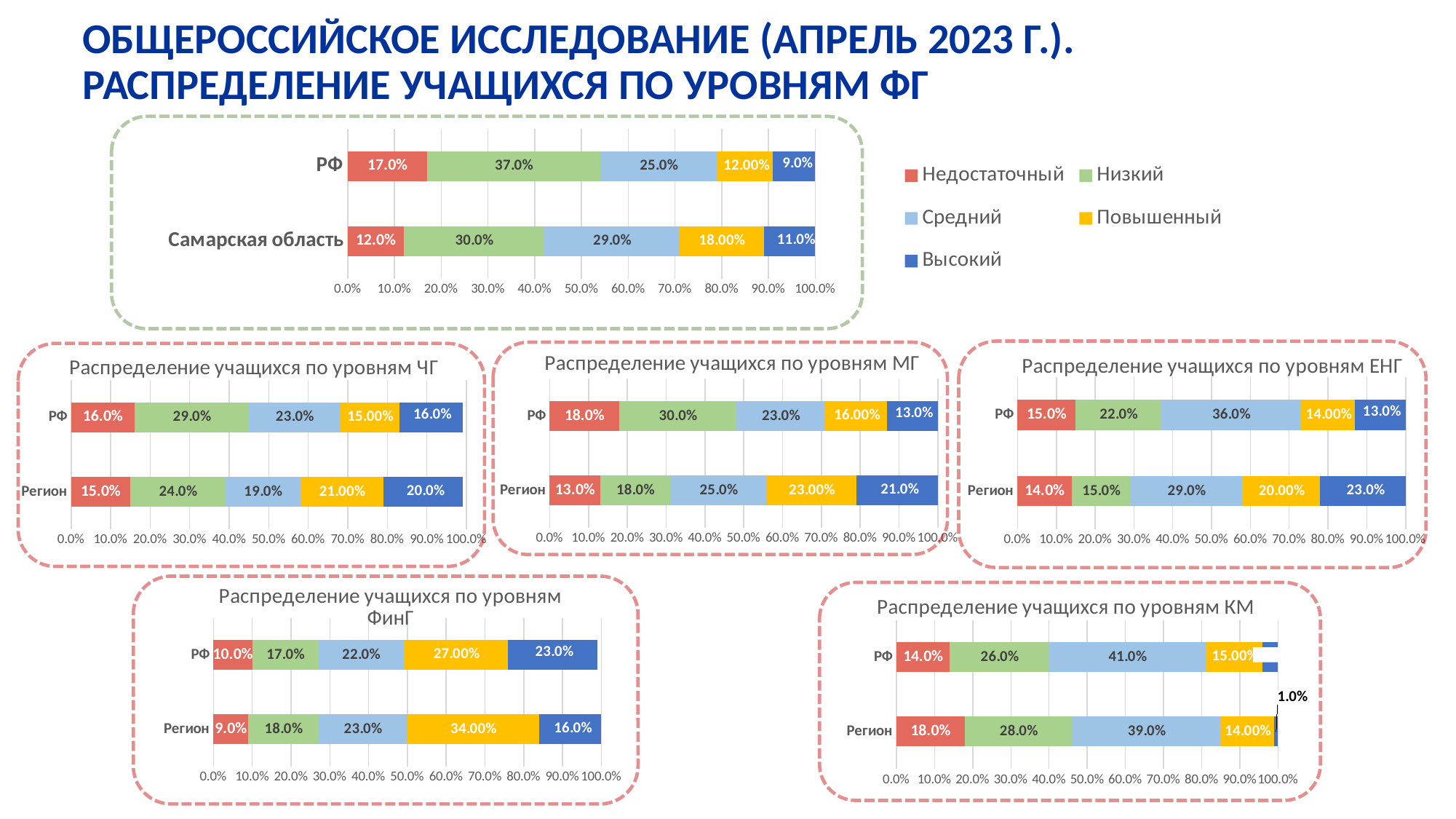
In the chart 'Распределение учащихся по уровням ФинГ', how much larger is the Повышенный share for Регион than for РФ? 7.00% In the chart 'Распределение учащихся по уровням МГ', which has the larger Недостаточный share, РФ or Регион? РФ In the chart 'Распределение учащихся по уровням ФинГ', what is the Повышенный value for Регион? 34.00% In the chart 'Распределение учащихся по уровням ЧГ', what is the Высокий value for Регион? 20.0% In the top chart (РФ vs Самарская область), what is the value of the Повышенный segment for Самарская область? 18.00% In the chart 'Распределение учащихся по уровням ЕНГ', what is the Средний value for РФ? 36.0% How many categories (bars) are shown in the top chart (РФ vs Самарская область)? 2 In the chart 'Распределение учащихся по уровням КМ', what is the Средний value for РФ? 41.0% In the top chart (РФ vs Самарская область), what is the value of the Низкий segment for РФ? 37.0% How many series does the legend next to the top chart list? 5 What kind of chart is 'Распределение учащихся по уровням ЧГ'? Stacked bar chart In the top chart (РФ vs Самарская область), which level has the largest share for РФ? Низкий